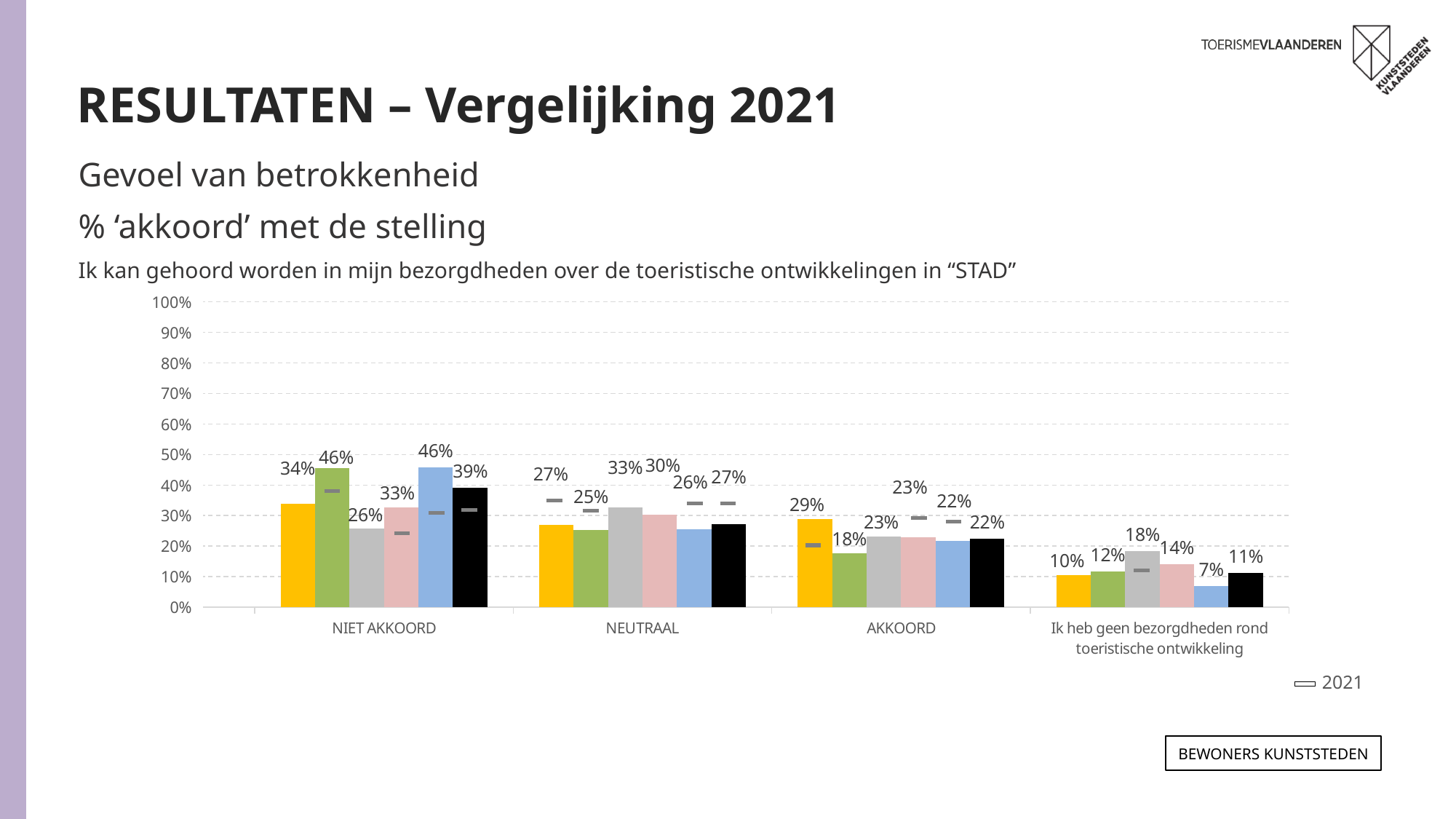
What is the value of the black bar in the NEUTRAAL category? 27% Which bar has the highest value in the AKKOORD category? the yellow bar (29%) Which bar has the lowest value in the NIET AKKOORD category? the grey bar (26%) Is the value of the black bar in the NIET AKKOORD category greater or less than 30%? greater What type of chart is shown on the slide? bar chart What entry does the chart legend list? 2021 What is the value of the yellow bar in the NIET AKKOORD category? 34% What is the difference between the grey bar and the blue bar in the 'Ik heb geen bezorgdheden rond toeristische ontwikkeling' category? 11% Which is larger in the NEUTRAAL category: the grey bar or the green bar? the grey bar How many categories are shown along the x axis of the chart? 4 What is the value of the blue bar in the 'Ik heb geen bezorgdheden rond toeristische ontwikkeling' category? 7% What is the difference between the green bar and the yellow bar in the NIET AKKOORD category? 12%